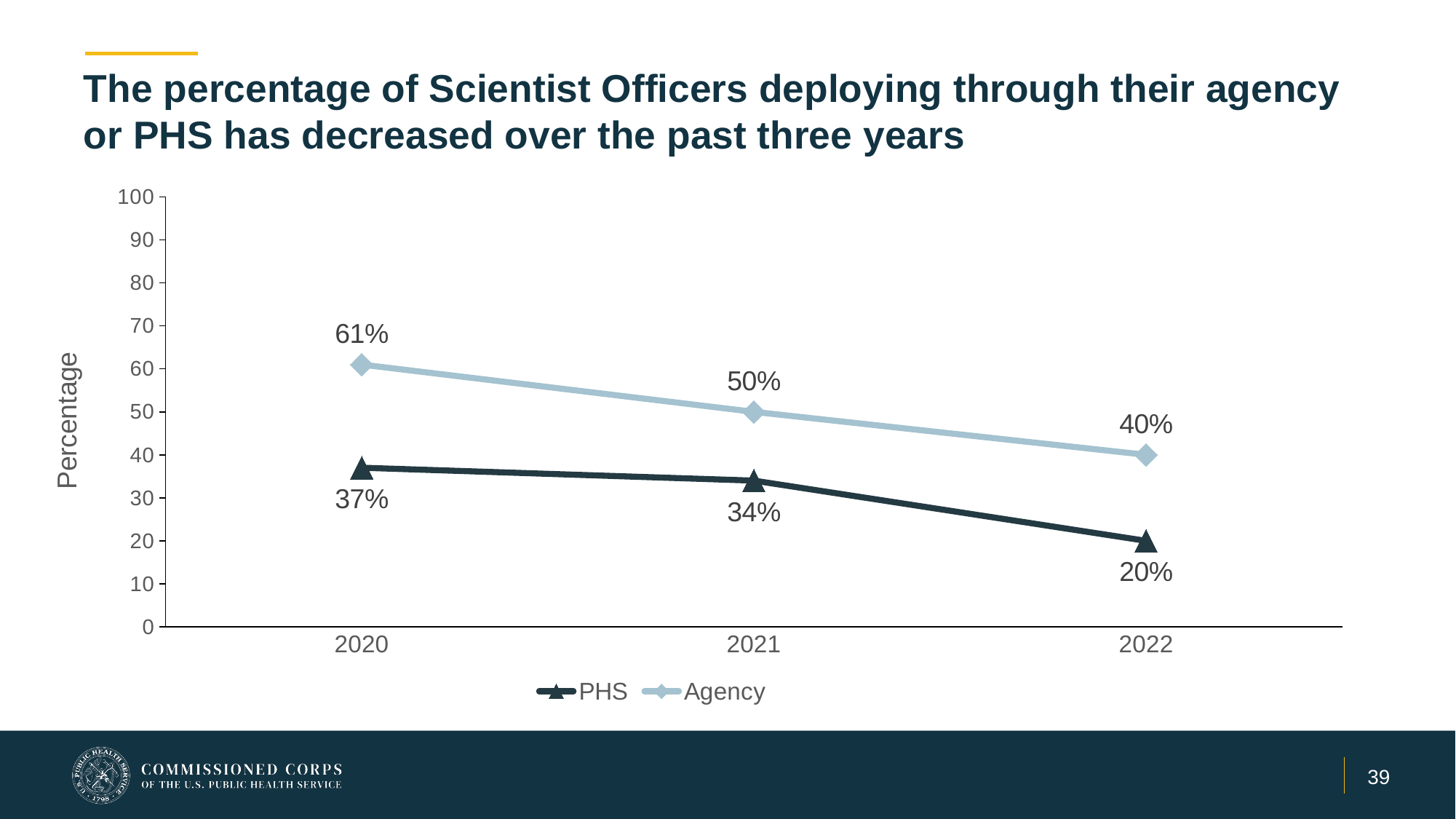
How many series does the legend list? 2 Which is larger in 2021, the PHS value or the Agency value? Agency What is the Agency value for 2022? 40% How many years are shown on the x axis? 3 What is the Agency value for 2020? 61% In which year is the Agency value highest? 2020 In which year is the PHS value lowest? 2022 What is the difference between the Agency and PHS values in 2020? 24% What is the PHS value for 2021? 34% Do the PHS values rise or fall from 2020 to 2022? Fall What kind of chart is shown on the slide? Line chart What is the PHS value for 2022? 20%